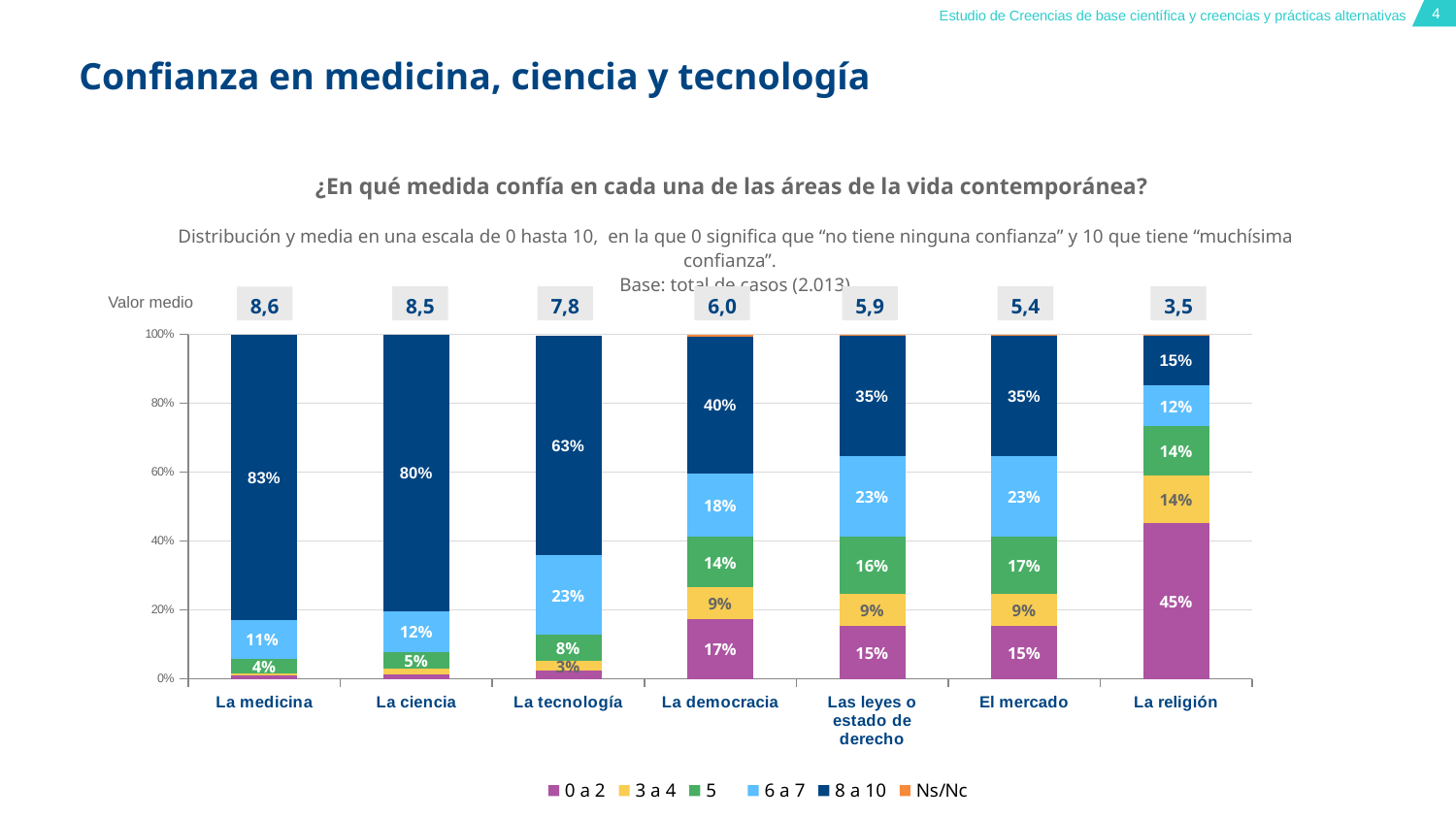
What is the 'Valor medio' shown for 'La religión'? 3,5 Which area has the highest 'Valor medio'? La medicina Which area has the largest share of respondents scoring 0 a 2? La religión What is the difference between the 8 a 10 share for 'La medicina' and for 'La tecnología'? 20 percentage points Which area has the lowest 'Valor medio'? La religión What percentage of respondents gave 'La medicina' a score of 8 a 10? 83% What percentage of respondents gave 'El mercado' a score of 6 a 7? 23% What kind of chart is shown on the slide? Stacked bar chart How many areas are shown on the x axis of the chart? 7 What percentage of respondents gave 'La democracia' a score of 0 a 2? 17% How many series does the legend list? 6 Which has a larger 8 a 10 share, 'La ciencia' or 'La democracia'? La ciencia